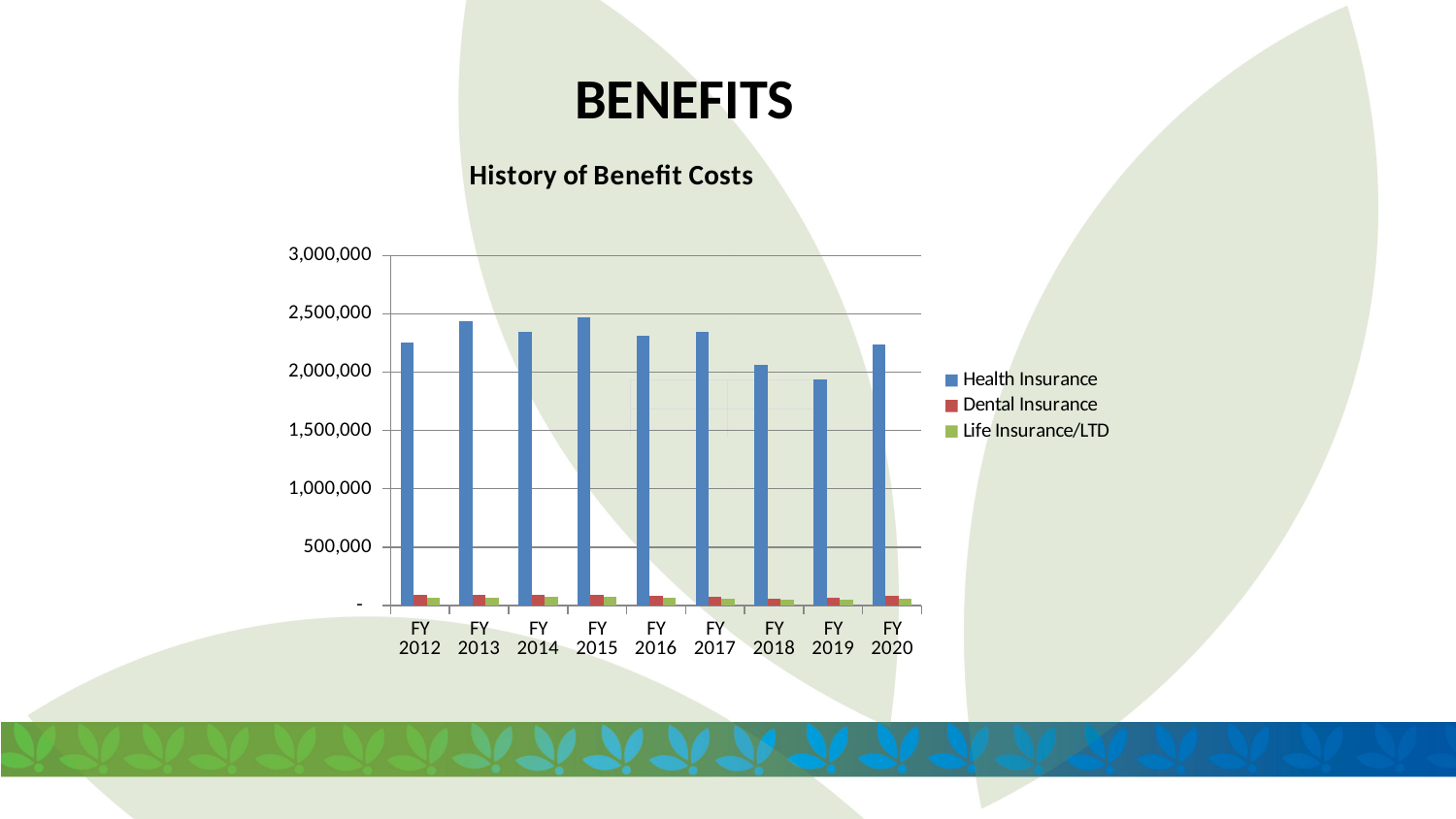
In which fiscal year is the Health Insurance cost lowest? FY 2019 Which is larger, the Health Insurance cost in FY 2012 or in FY 2019? FY 2012 Does the Health Insurance cost rise or fall from FY 2015 to FY 2019? fall Which series has the largest values in every fiscal year? Health Insurance Which series is shown in blue in the legend? Health Insurance Is the Health Insurance value for FY 2019 greater or less than 2,000,000? less What is the title of the chart? History of Benefit Costs What kind of chart is shown on the slide? bar chart Is the Health Insurance value for FY 2013 greater or less than 2,000,000? greater How many fiscal years are shown on the x axis? 9 How many series does the legend list? 3